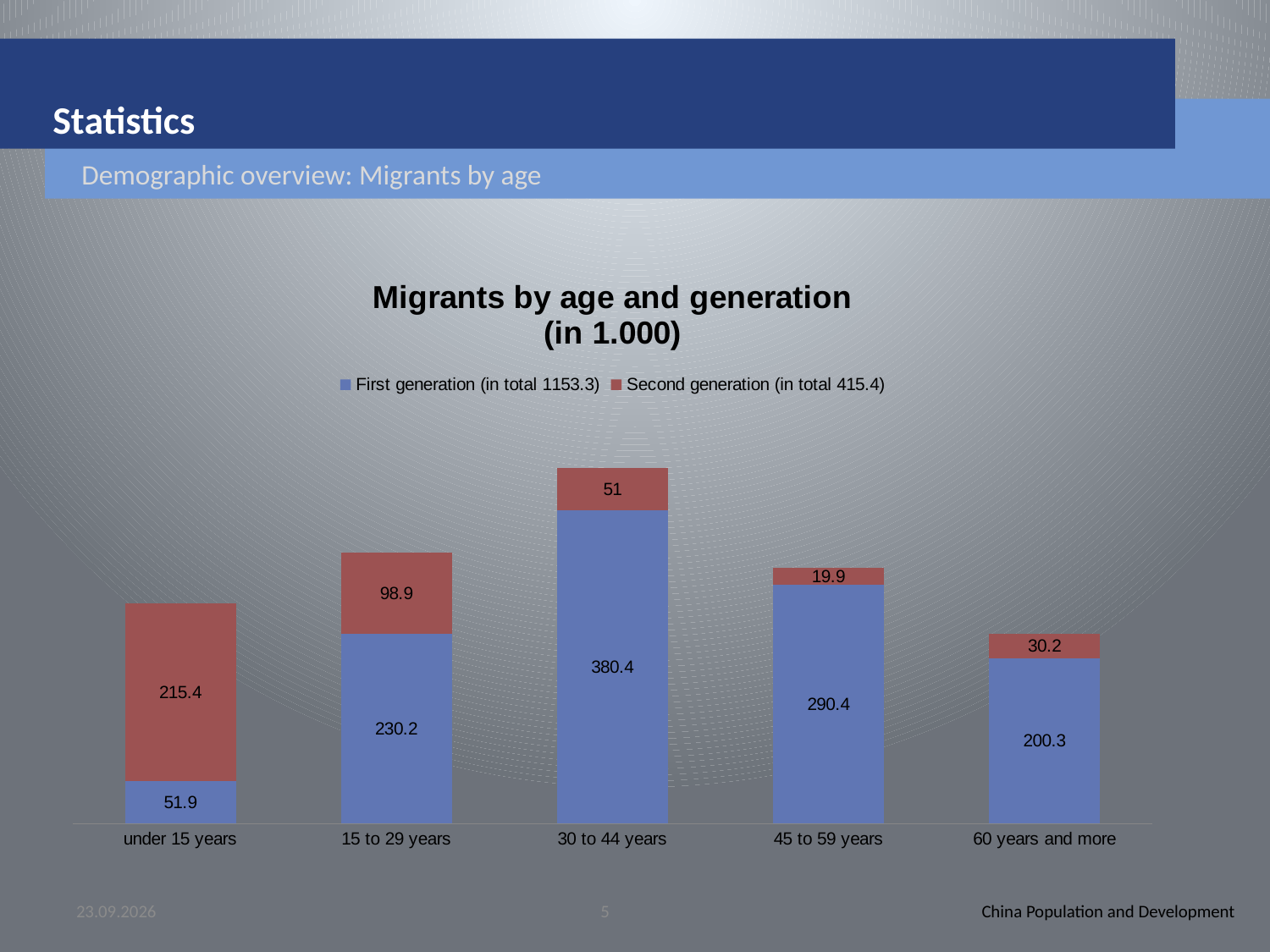
What is the First generation value for 60 years and more? 200.3 Which age group has the lowest Second generation value? 45 to 59 years What type of chart is shown on the slide? Stacked bar chart What is the total of the stacked bar for the 30 to 44 years age group? 431.4 What is the First generation value for the 30 to 44 years age group? 380.4 How many series does the legend list? 2 Which is larger: the Second generation value for 15 to 29 years or for 60 years and more? 15 to 29 years Which age group has the highest First generation value? 30 to 44 years What is the difference between the First generation values for 30 to 44 years and 45 to 59 years? 90 How many age groups are shown on the x axis? 5 What is the Second generation value for the under 15 years age group? 215.4 What is the total of the stacked bar for the under 15 years age group? 267.3